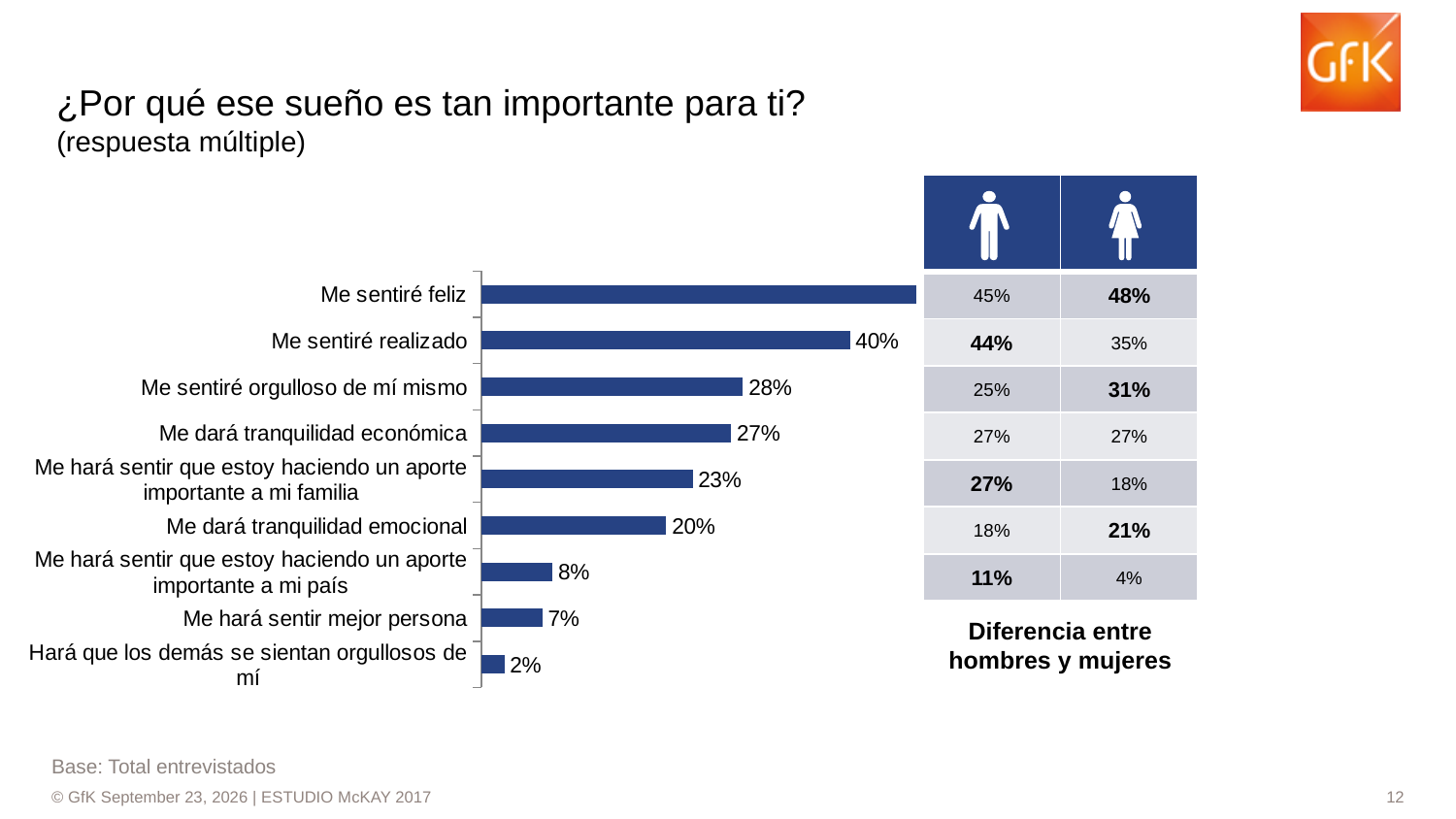
Which category has the highest value in the bar chart? Me sentiré feliz What is the value for "Me hará sentir mejor persona"? 7% What is the value for "Me hará sentir que estoy haciendo un aporte importante a mi familia"? 23% What is the value for "Me dará tranquilidad económica"? 27% What type of chart is shown on the slide? Bar chart Which is larger: the value for "Me hará sentir que estoy haciendo un aporte importante a mi país" or the value for "Me hará sentir mejor persona"? Me hará sentir que estoy haciendo un aporte importante a mi país What is the title of the slide containing the bar chart? ¿Por qué ese sueño es tan importante para ti? What is the difference between the values for "Me sentiré realizado" and "Me dará tranquilidad emocional"? 20% How many categories does the bar chart show? 9 What is the value for "Me sentiré realizado"? 40% Which category has the lowest value in the bar chart? Hará que los demás se sientan orgullosos de mí What is the value for "Me sentiré orgulloso de mí mismo"? 28%